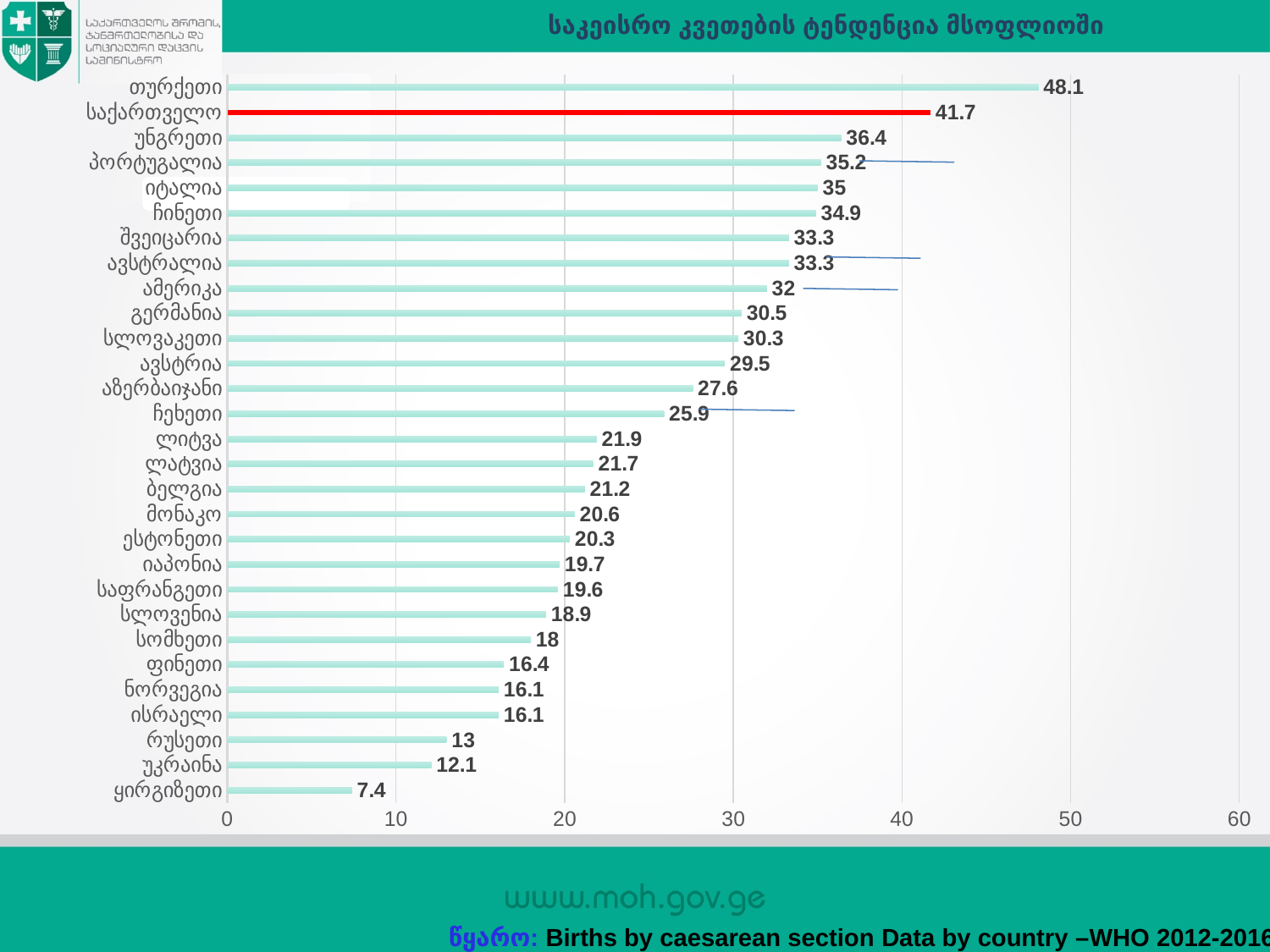
Is the value for ამერიკა (America) greater or less than 30? greater What is the value for საქართველო (Georgia), shown with the red bar? 41.7 How many countries are shown in the chart? 29 Which bar is highlighted in red in the chart? საქართველო Which has a larger value, უნგრეთი (Hungary) or გერმანია (Germany)? უნგრეთი What is the value for თურქეთი (Turkey)? 48.1 Which country has the highest value in the chart? თურქეთი What is the difference between the values for თურქეთი (48.1) and საქართველო (41.7)? 6.4 Which country has the lowest value in the chart? ყირგიზეთი What is the value for ყირგიზეთი (Kyrgyzstan)? 7.4 What type of chart is shown on the slide? bar chart What is the value for რუსეთი (Russia)? 13